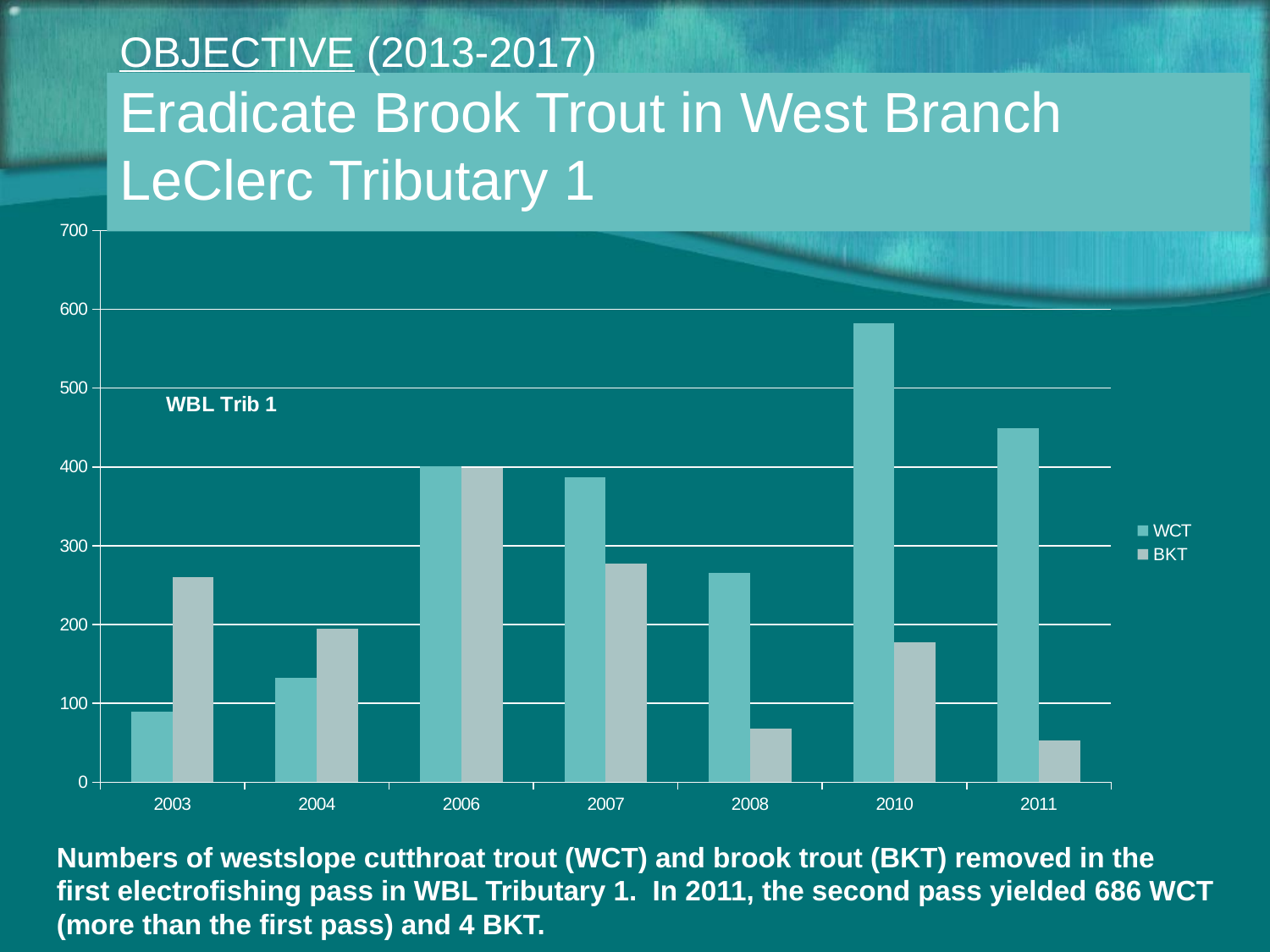
Which year has the highest WCT value? 2010 What label is printed inside the plot area of the chart? WBL Trib 1 How many series does the chart legend list? 2 What kind of chart is shown on the slide? bar chart In 2003, which is larger, the WCT value or the BKT value? BKT In 2011, which is larger, the WCT value or the BKT value? WCT Which year has the lowest BKT value? 2011 Is the BKT value for 2008 greater or less than 100? less Which year has the highest BKT value? 2006 Which year has the lowest WCT value? 2003 How many years are shown on the x axis of the chart? 7 Is the WCT value for 2010 greater or less than 500? greater